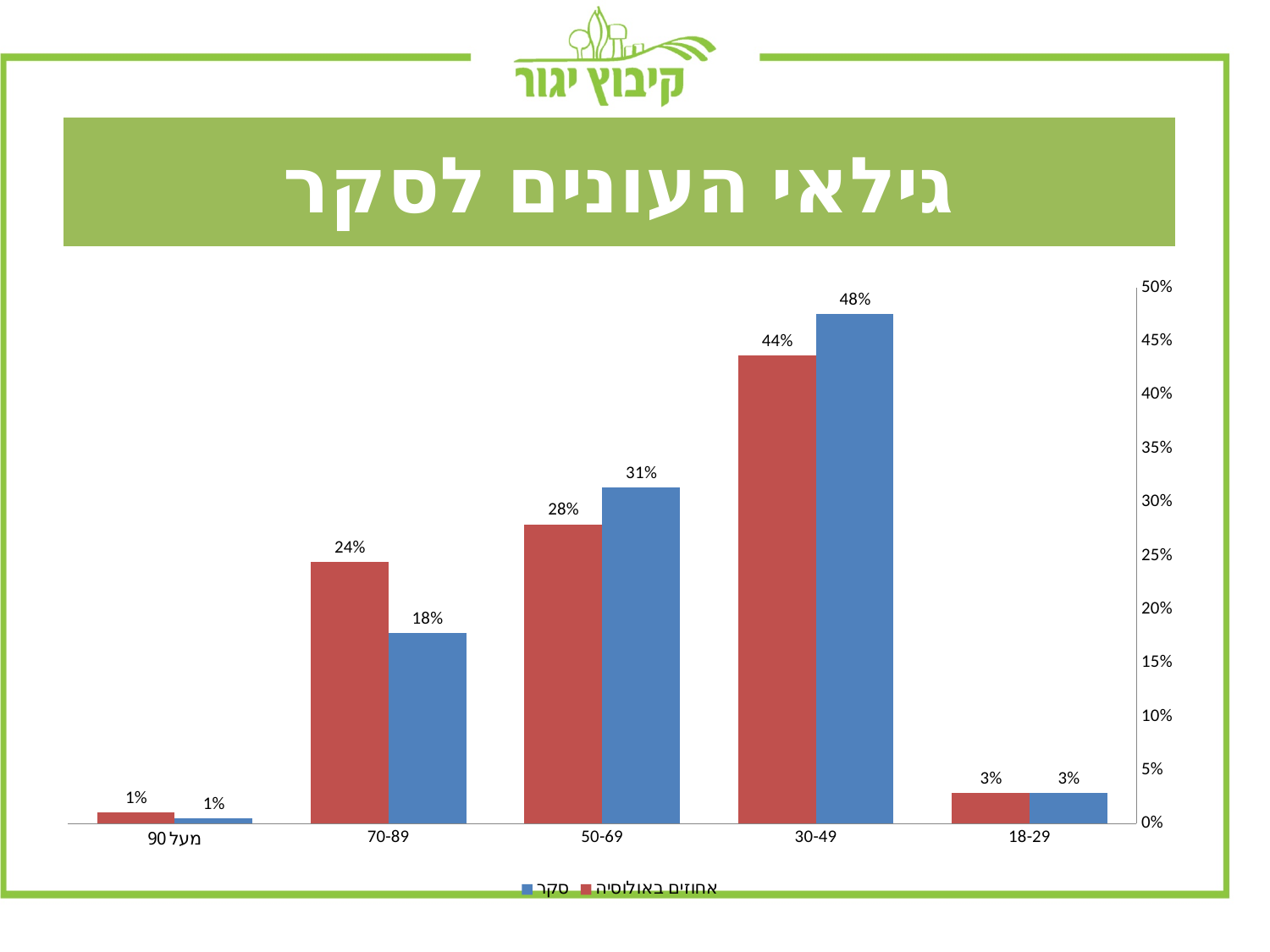
For the 50-69 age group, which is larger: the blue (סקר) bar or the red (אחוזים באוכלוסיה) bar? blue (סקר) What kind of chart is shown on the slide? bar chart What is the value of the blue (סקר) bar for the 30-49 age group? 48% What is the value of the red (אחוזים באוכלוסיה) bar for the 70-89 age group? 24% How many series does the legend list? 2 What is the title of the chart on the slide? גילאי העונים לסקר Which age group has the highest value in the blue (סקר) series? 30-49 What is the difference between the blue (סקר) and red (אחוזים באוכלוסיה) bars for the 70-89 age group? 6% What is the difference between the blue (סקר) and red (אחוזים באוכלוסיה) bars for the 30-49 age group? 4% How many age categories are shown on the x axis? 5 What is the value of the blue (סקר) bar for the 50-69 age group? 31% Which age group has the lowest value in the red (אחוזים באוכלוסיה) series? מעל 90